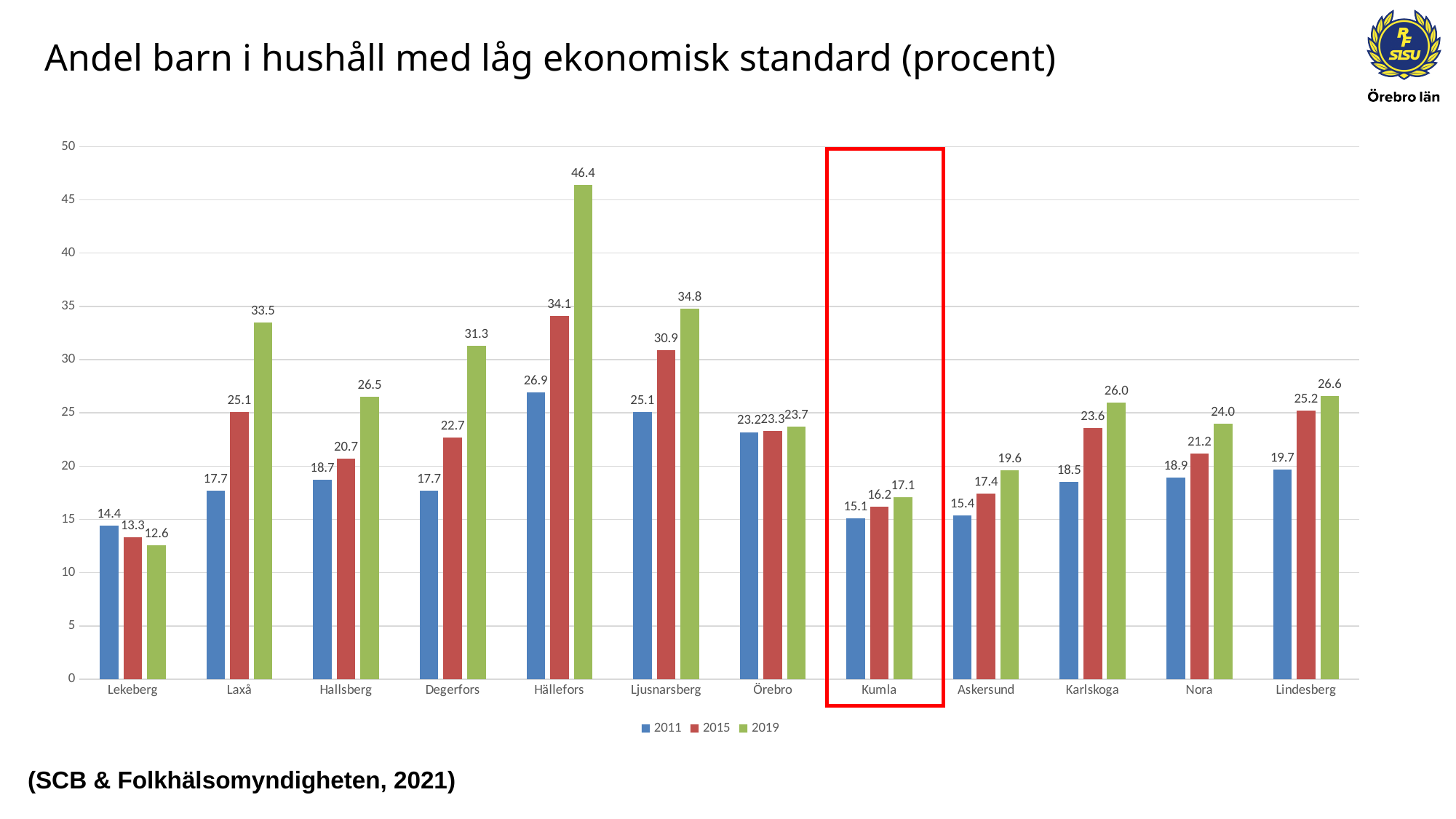
What is the value for Laxå in 2015? 25.1 Is the 2019 value for Hällefors greater or less than 45? greater Which municipality has the lowest value in 2019? Lekeberg Which municipality has the highest value in 2019? Hällefors What is the value for Kumla in 2011? 15.1 What is the difference between the 2019 and 2011 values for Degerfors? 13.6 Do the values for Lekeberg rise or fall from 2011 to 2019? Fall What is the value for Hällefors in 2019? 46.4 How many series does the legend list? 3 What kind of chart is shown on the slide? Bar chart How many municipalities are shown on the x axis? 12 Which is larger, the 2019 value for Ljusnarsberg or the 2019 value for Laxå? Ljusnarsberg